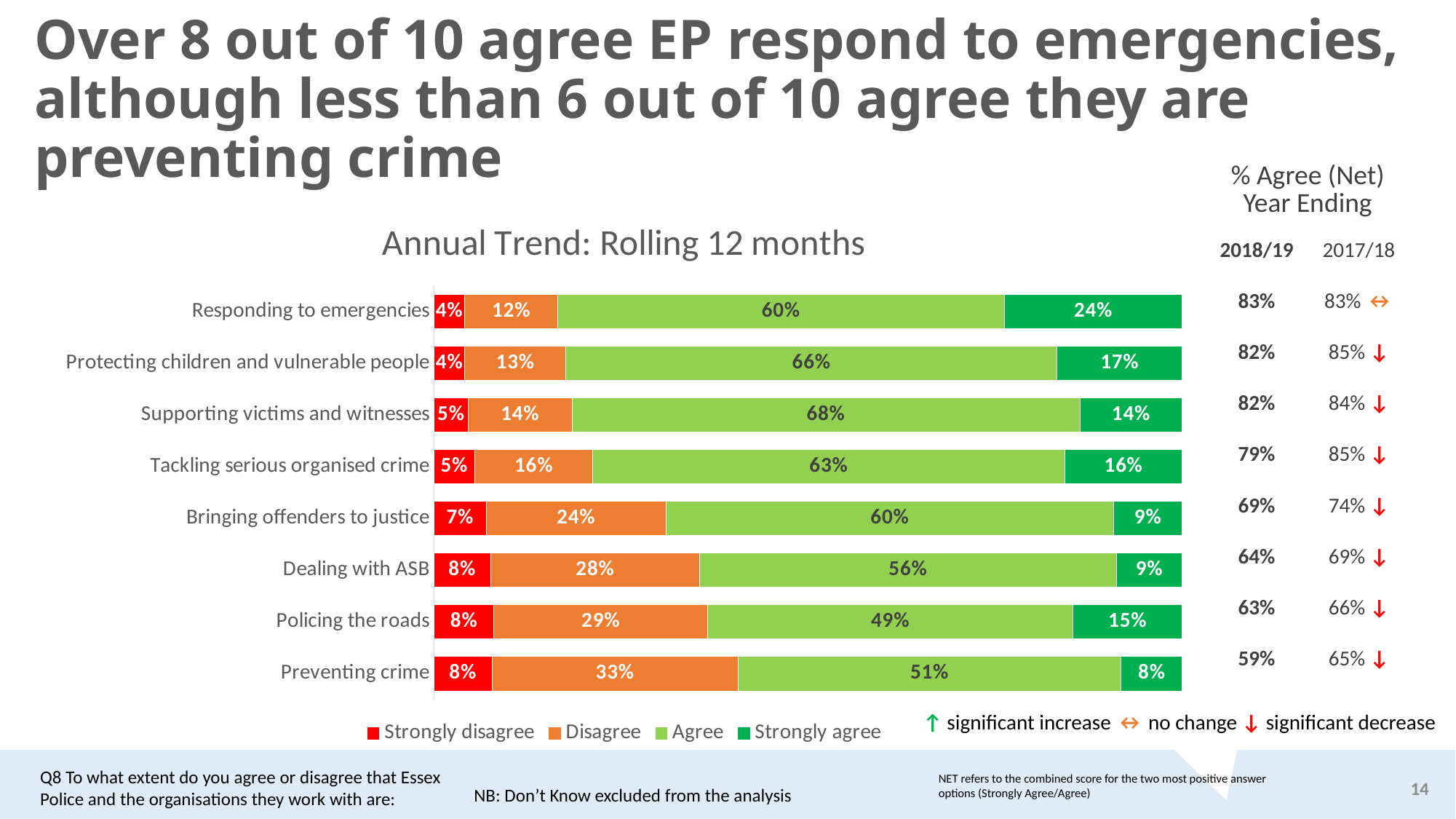
Which category has the lowest 'Agree' percentage? Policing the roads What percentage of respondents 'Agree' that Essex Police are supporting victims and witnesses? 68% Which category has the highest 'Strongly agree' percentage? Responding to emergencies What is the title of the chart? Annual Trend: Rolling 12 months Which has a larger 'Strongly disagree' value: 'Bringing offenders to justice' or 'Tackling serious organised crime'? Bringing offenders to justice What is the 'Strongly agree' value for 'Responding to emergencies'? 24% How many series does the legend list? 4 What is the 'Disagree' value for 'Preventing crime'? 33% What is the combined 'Agree' and 'Strongly agree' total for 'Dealing with ASB'? 65% What is the difference between the 'Disagree' values for 'Preventing crime' and 'Responding to emergencies'? 21% What kind of chart is shown on the slide? Stacked bar chart How many categories are shown in the chart? 8